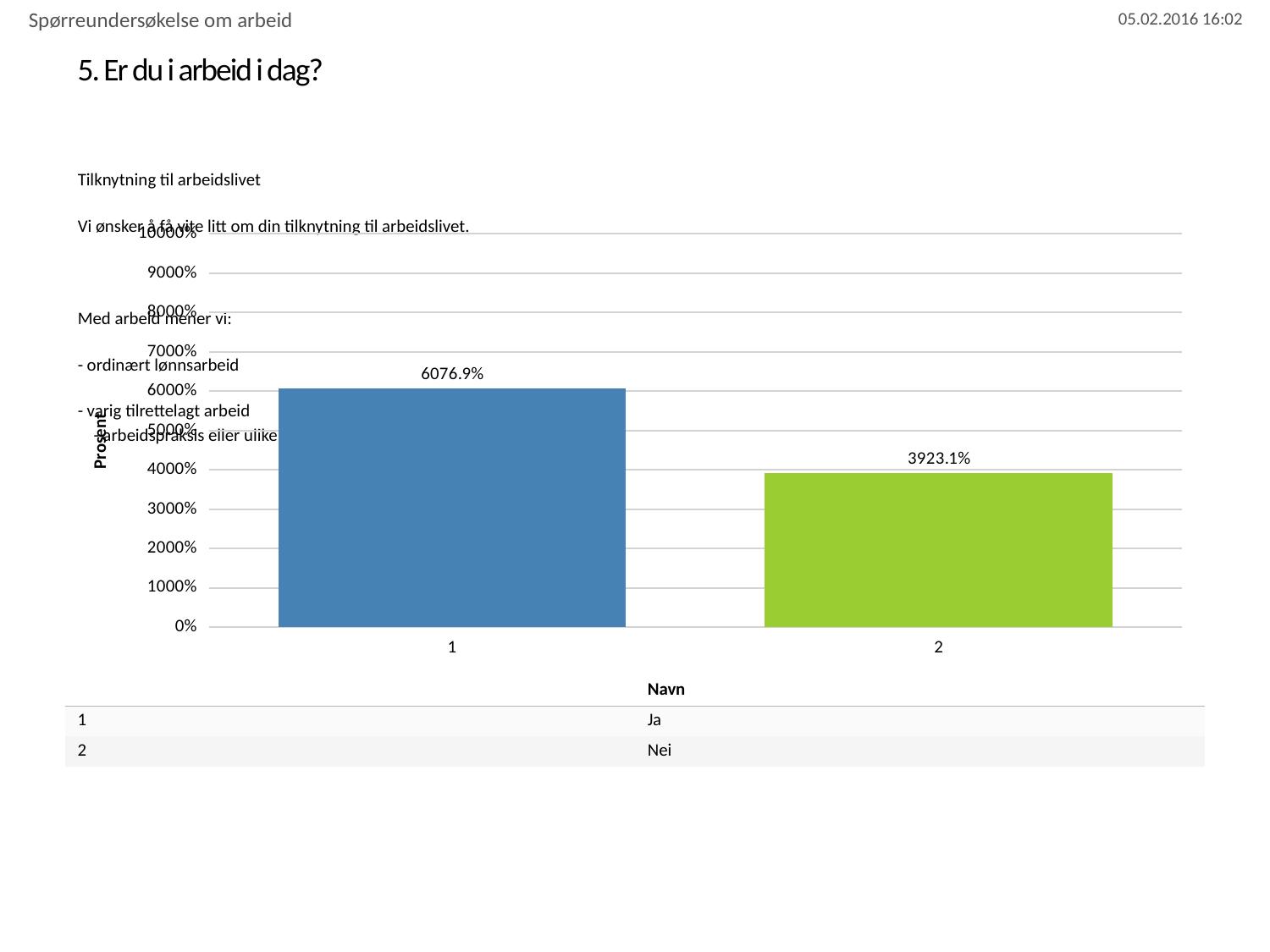
Is the value for category 1 greater or less than 6000%? greater What is the difference between the values for category 1 and category 2? 2153.8% What is the label of the y axis? Prosent What is the value shown for category 2? 3923.1% Which category has the lowest value? 2 How many categories are plotted in the chart? 2 What kind of chart is shown on the slide? Bar chart What is the value shown for category 1? 6076.9% Which category has the highest value? 1 Which is larger, the value for category 1 or category 2? Category 1 Is the value for category 2 greater or less than 4000%? less According to the table below the chart, what name does category 2 correspond to? Nei